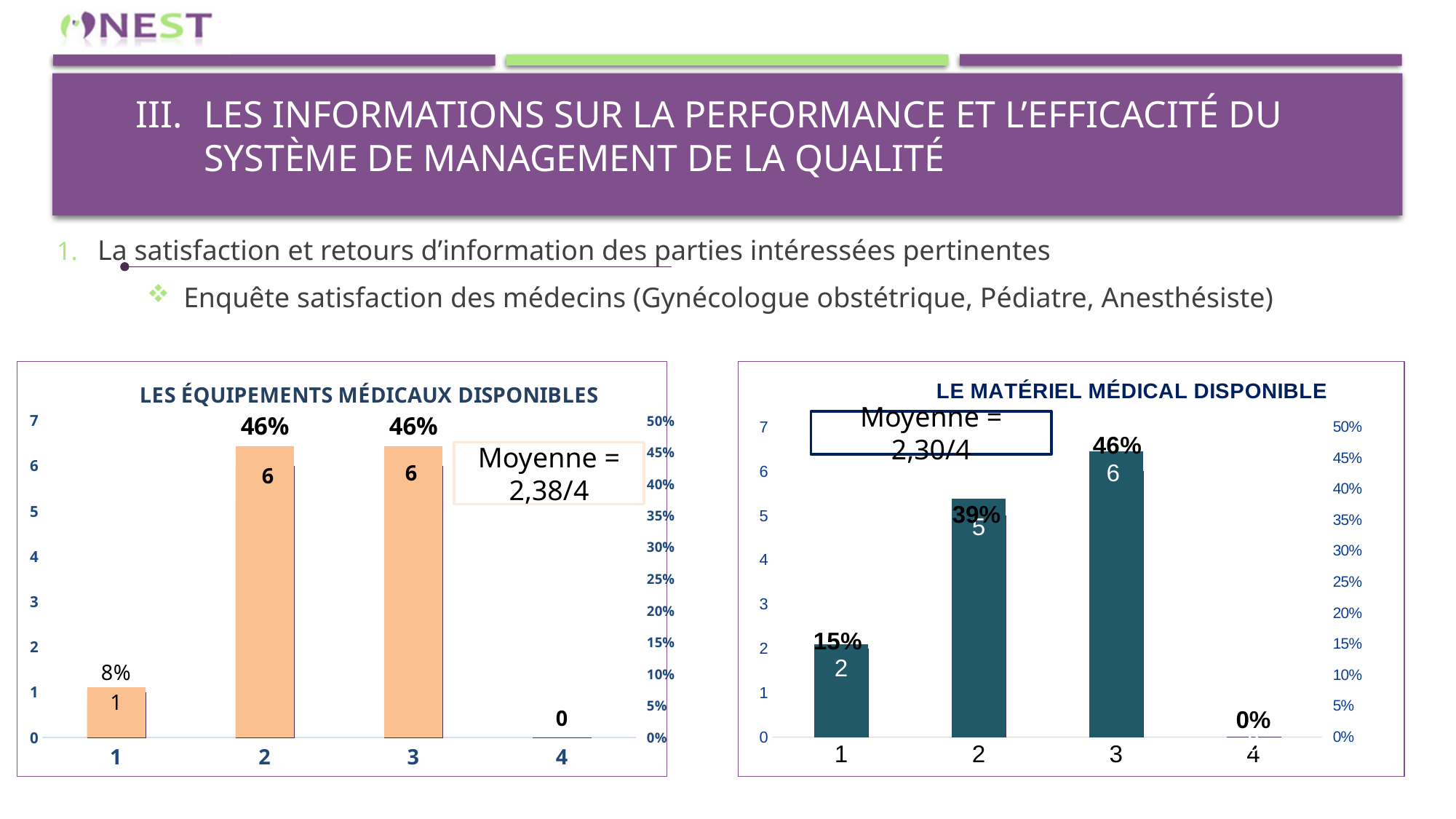
In the chart titled "LES ÉQUIPEMENTS MÉDICAUX DISPONIBLES", how many categories are shown on the x axis? 4 In the chart titled "LE MATÉRIEL MÉDICAL DISPONIBLE", which category has the highest value? 3 In the chart titled "LE MATÉRIEL MÉDICAL DISPONIBLE", which is larger, the value for category 2 or the value for category 3? 3 In the chart titled "LES ÉQUIPEMENTS MÉDICAUX DISPONIBLES", what is the average (Moyenne) shown in the text box? 2,38/4 What type of chart is "LE MATÉRIEL MÉDICAL DISPONIBLE"? bar chart In the chart titled "LES ÉQUIPEMENTS MÉDICAUX DISPONIBLES", what is the count value for category 2? 6 In the chart titled "LE MATÉRIEL MÉDICAL DISPONIBLE", what is the count value for category 2? 5 In the chart titled "LES ÉQUIPEMENTS MÉDICAUX DISPONIBLES", which category has the lowest value? 4 In the chart titled "LE MATÉRIEL MÉDICAL DISPONIBLE", what percentage is shown for category 1? 15% In the chart titled "LES ÉQUIPEMENTS MÉDICAUX DISPONIBLES", what percentage is shown for category 1? 8% In the chart titled "LE MATÉRIEL MÉDICAL DISPONIBLE", what is the average (Moyenne) shown in the text box? 2,30/4 In the chart titled "LE MATÉRIEL MÉDICAL DISPONIBLE", what is the difference between the count for category 3 and the count for category 1? 4